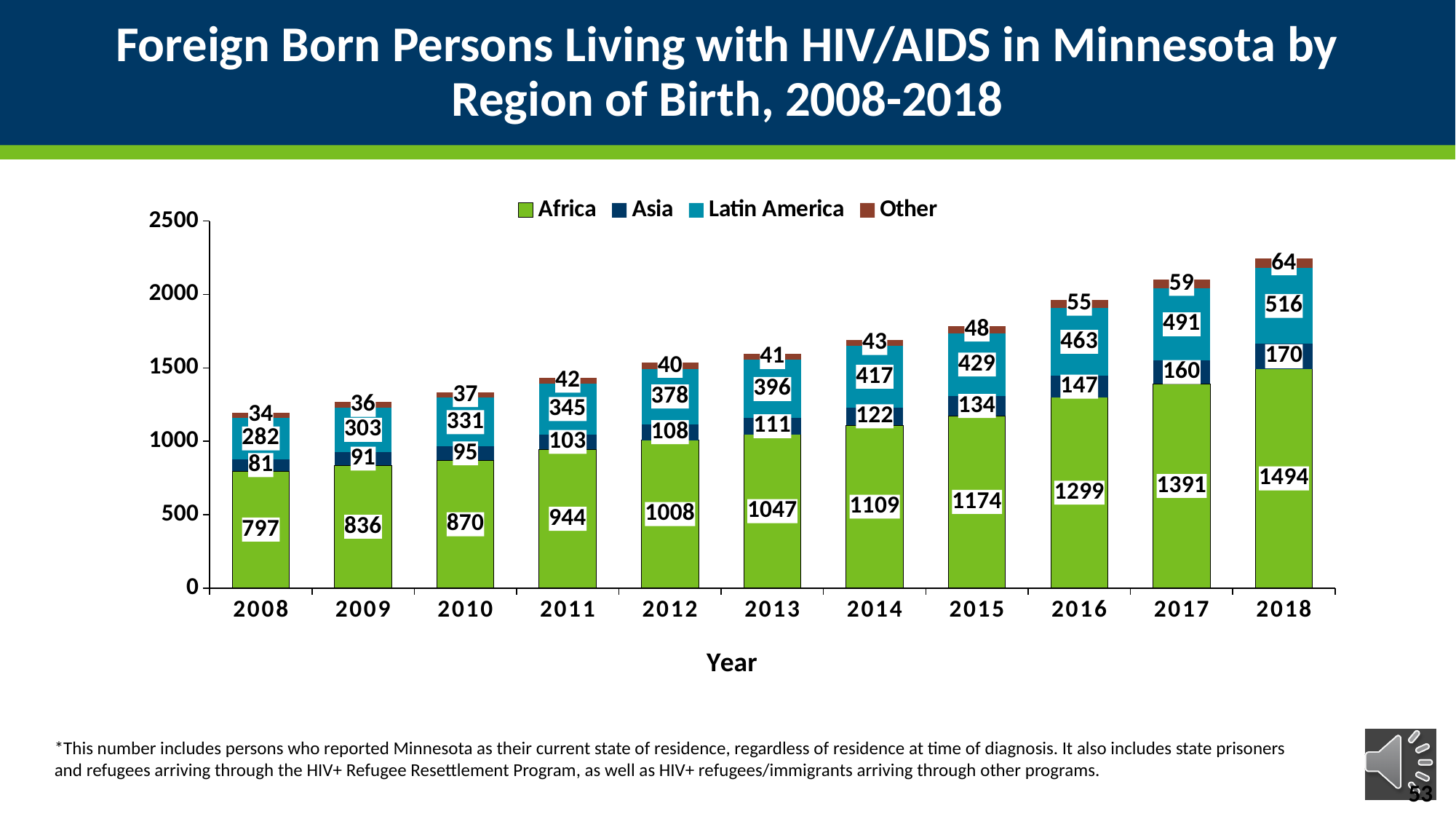
How many series does the legend list? 4 What is the difference between the Africa values for 2018 and 2008? 697 In which year is the Latin America value lowest? 2008 What is the total of the stacked bar for 2008? 1194 What is the total of the stacked bar for 2018? 2244 In which year is the Africa value highest? 2018 How many years are shown on the x axis? 11 What is the value for Africa in 2018? 1494 What is the value for Other in 2010? 37 What is the value for Asia in 2015? 134 Which is larger, the Asia value in 2017 or the Asia value in 2014? 2017 What is the value for Latin America in 2012? 378